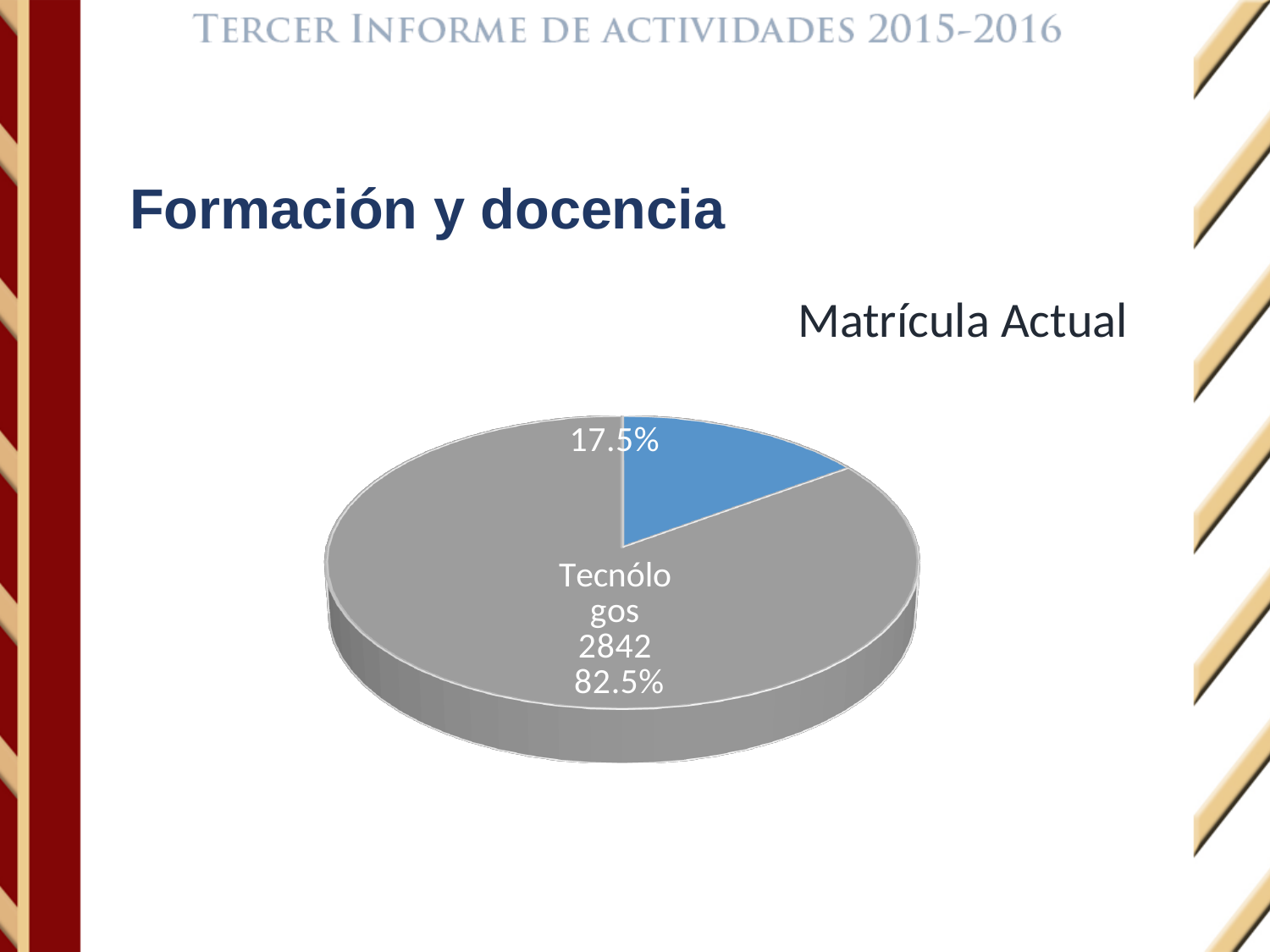
What is the difference in percentage points between the Tecnólogos share and the blue slice's share? 65 percentage points What colour is the Tecnólogos slice? gray What share of the pie does Tecnólogos represent? 82.5% What is the value shown for Tecnólogos? 2842 How many slices does the pie chart have? 2 What share of the pie does the blue slice represent? 17.5% What kind of chart is shown on the slide? pie chart Which slice is the largest in the pie chart? Tecnólogos What is the title of the chart? Matrícula Actual Which is larger, the Tecnólogos slice or the blue slice? Tecnólogos